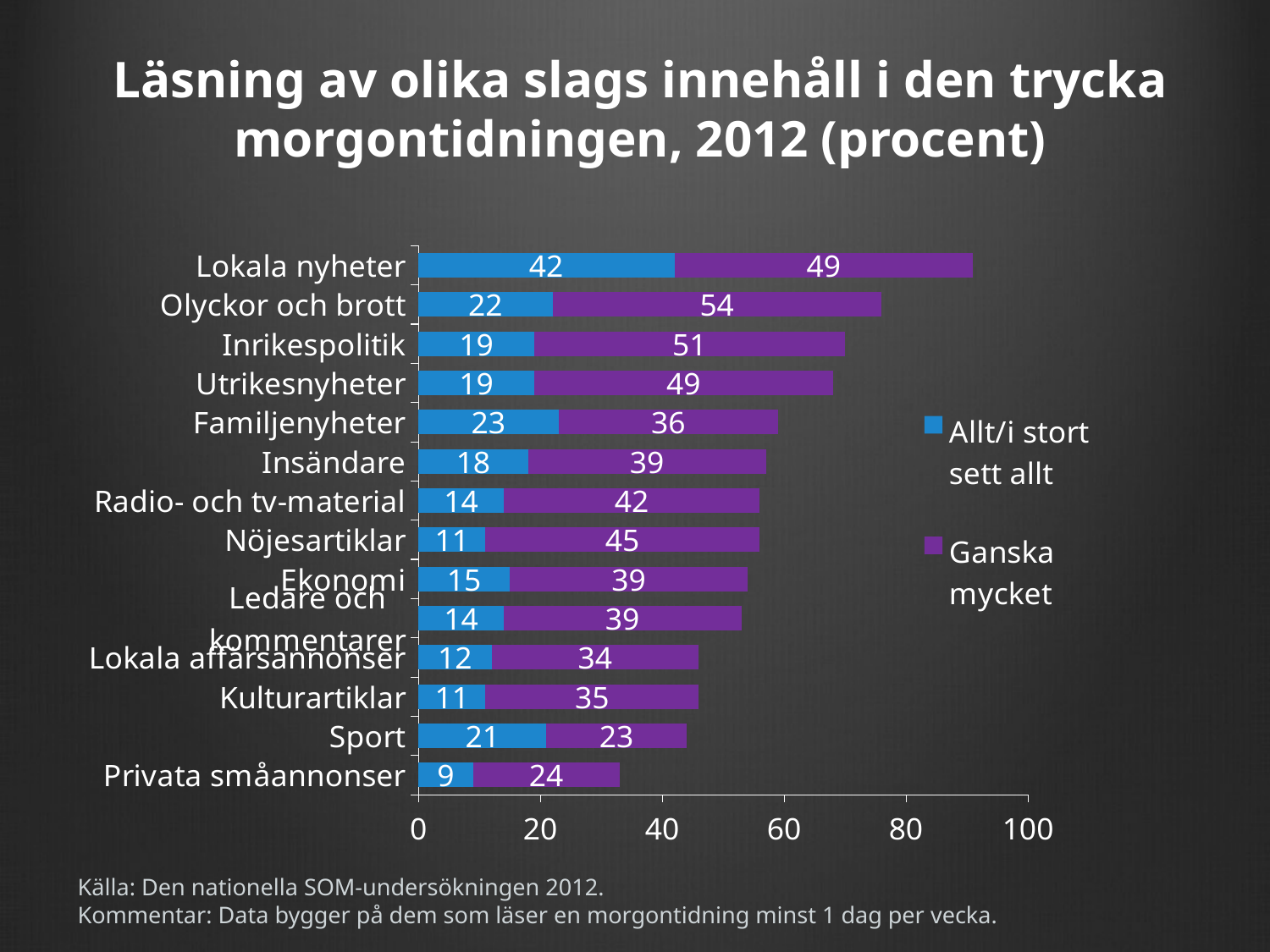
What is the value of 'Ganska mycket' for Sport? 23 Which category has the lowest 'Allt/i stort sett allt' value? Privata småannonser How many series does the legend list? 2 What is the difference between the 'Ganska mycket' values for Inrikespolitik and Familjenyheter? 15 Which series is shown in purple in the legend? Ganska mycket What is the total of the stacked bar for Lokala nyheter? 91 Which is larger: the 'Allt/i stort sett allt' value for Sport or for Insändare? Sport What is the value of 'Ganska mycket' for Olyckor och brott? 54 What is the value of 'Allt/i stort sett allt' for Lokala nyheter? 42 What kind of chart is shown on the slide? Stacked bar chart How many categories are plotted on the chart? 14 Which category has the highest 'Allt/i stort sett allt' value? Lokala nyheter